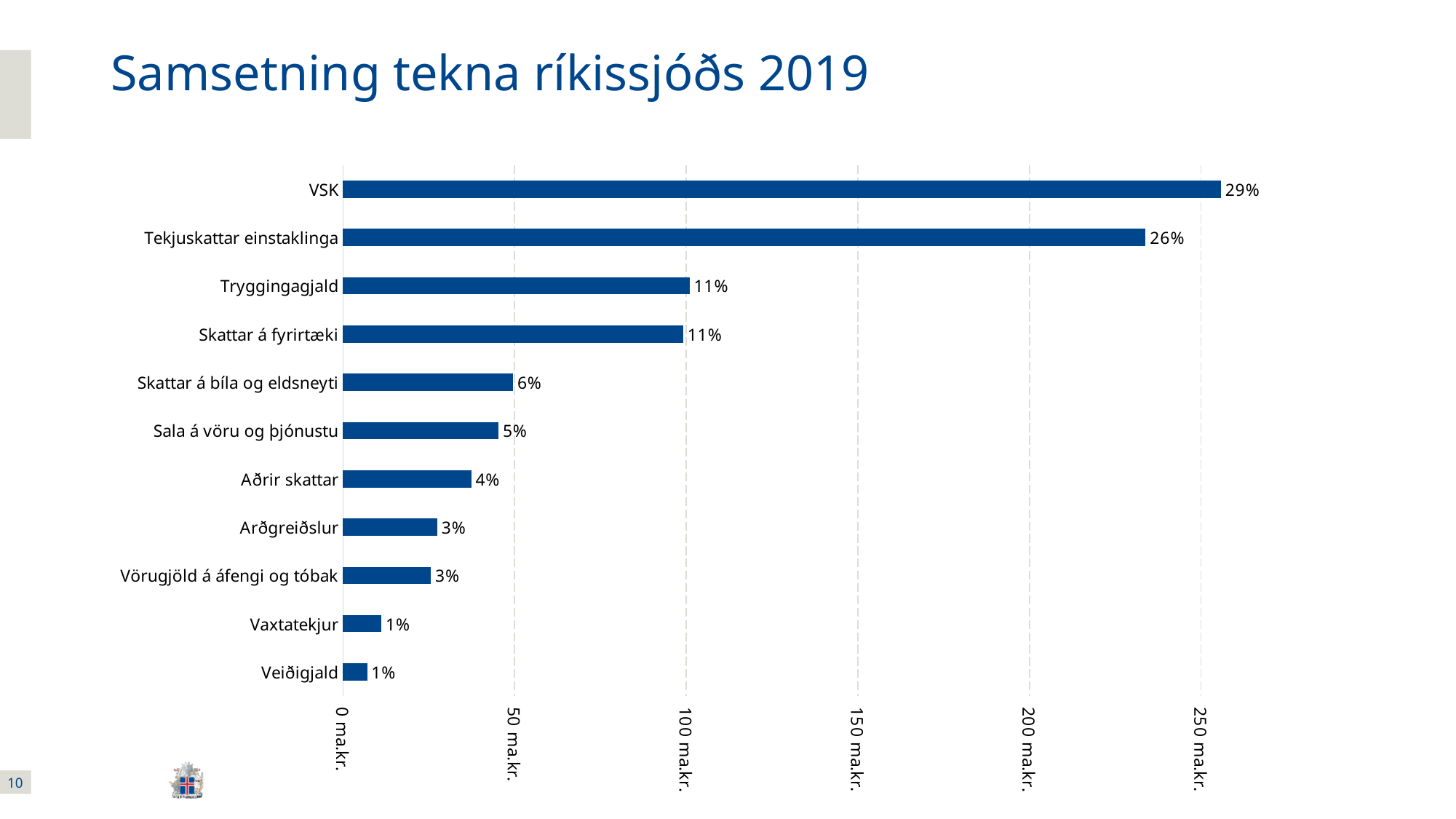
What percentage is shown for Tekjuskattar einstaklinga? 26% Is the value for Tekjuskattar einstaklinga greater or less than 200 ma.kr.? greater What percentage is shown for Skattar á bíla og eldsneyti? 6% What type of chart is shown on the slide? Bar chart What percentage is shown for Aðrir skattar? 4% What percentage is shown for VSK? 29% How many categories are shown in the chart? 11 Which is larger, Sala á vöru og þjónustu or Arðgreiðslur? Sala á vöru og þjónustu Is the value for Tryggingagjald greater or less than 50 ma.kr.? greater Which category has the highest value? VSK What is the difference in percentage points between VSK and Tekjuskattar einstaklinga? 3 percentage points Is the value for Aðrir skattar greater or less than 50 ma.kr.? less